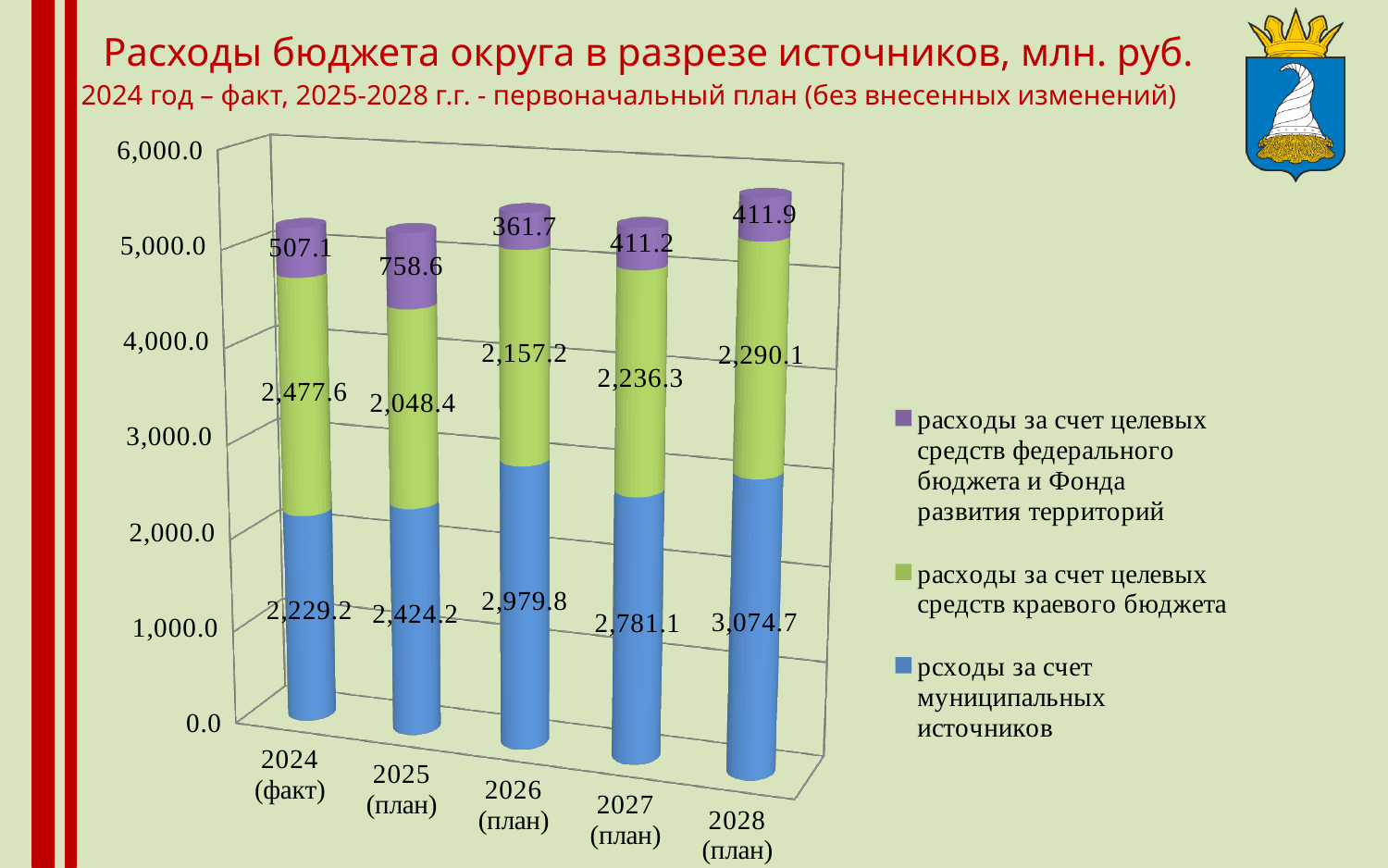
In which year is the value for federal budget funds (purple segment) the lowest? 2026 (план) In which year is the value for municipal sources (blue segment) the highest? 2028 (план) What is the total of the stacked bar for 2024 (факт)? 5,213.9 How many years (categories) are shown on the x axis? 5 Which is larger in 2025 (план): the municipal sources value or the regional budget funds value? municipal sources (2,424.2) What is the value for regional budget funds (расходы за счет целевых средств краевого бюджета) in 2024 (факт)? 2,477.6 What is the value for municipal sources (расходы за счет муниципальных источников) in 2028 (план)? 3,074.7 What type of chart is shown on the slide? stacked bar chart What is the total of the stacked bar for 2028 (план)? 5,776.7 What is the value for federal budget and Territory Development Fund funds (расходы за счет целевых средств федерального бюджета и Фонда развития территорий) in 2025 (план)? 758.6 What is the difference between the municipal sources values for 2028 (план) and 2024 (факт)? 845.5 How many series does the legend list? 3